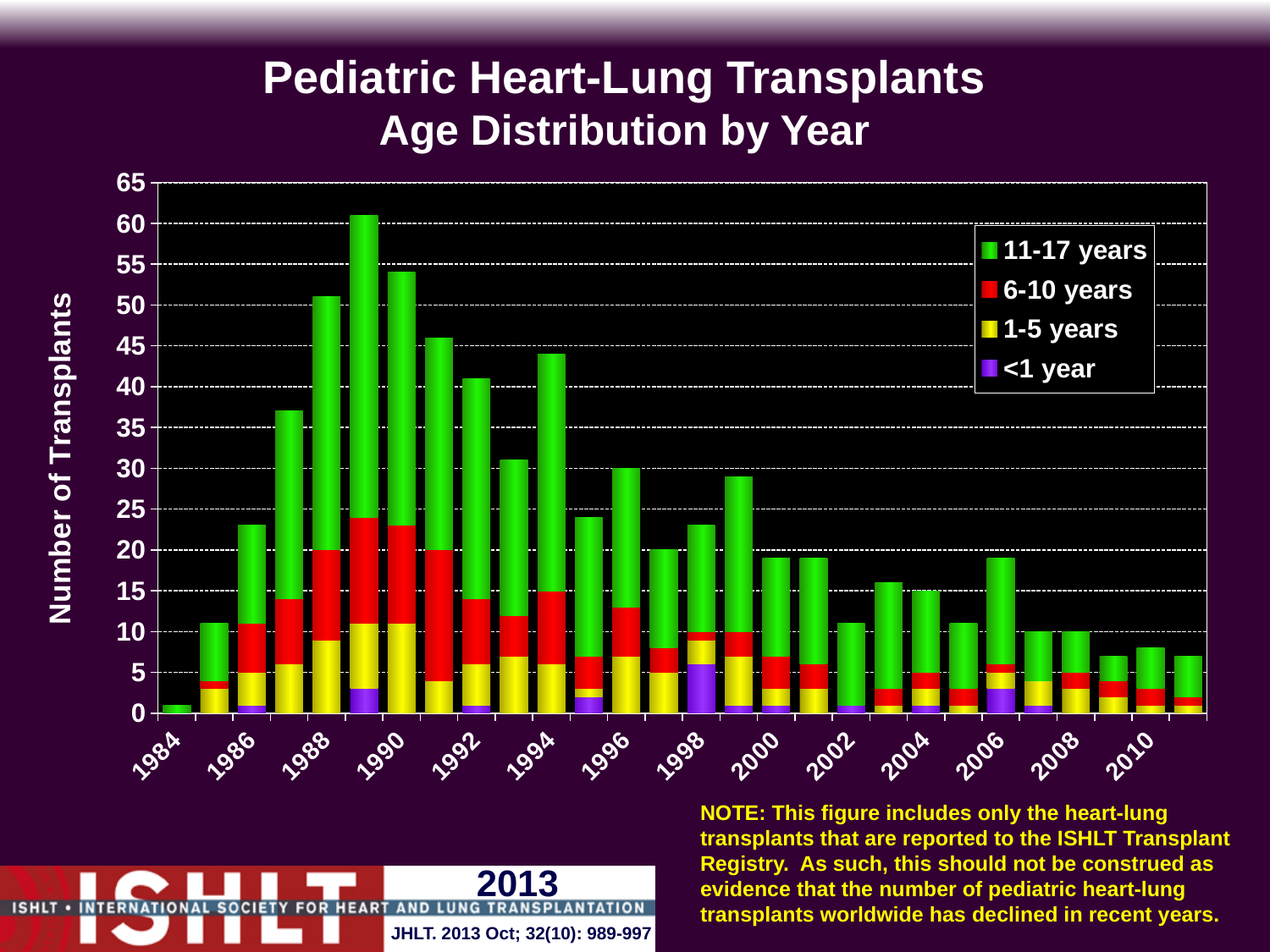
What kind of chart is shown on the slide? Stacked bar chart Which age group is shown in green in the legend? 11-17 years Is the total number of transplants for 2011 greater or less than 10? less Which year has the highest total number of transplants? 1989 Which year has a higher total number of transplants, 1990 or 1992? 1990 Is the total number of transplants for 1984 greater or less than 5? less Is the total number of transplants for 1994 greater or less than 40? greater How many series does the legend list? 4 What is the label on the y axis? Number of Transplants Which year has the lowest total number of transplants? 1984 Do the total numbers of transplants generally rise or fall from 1989 to 2011? fall